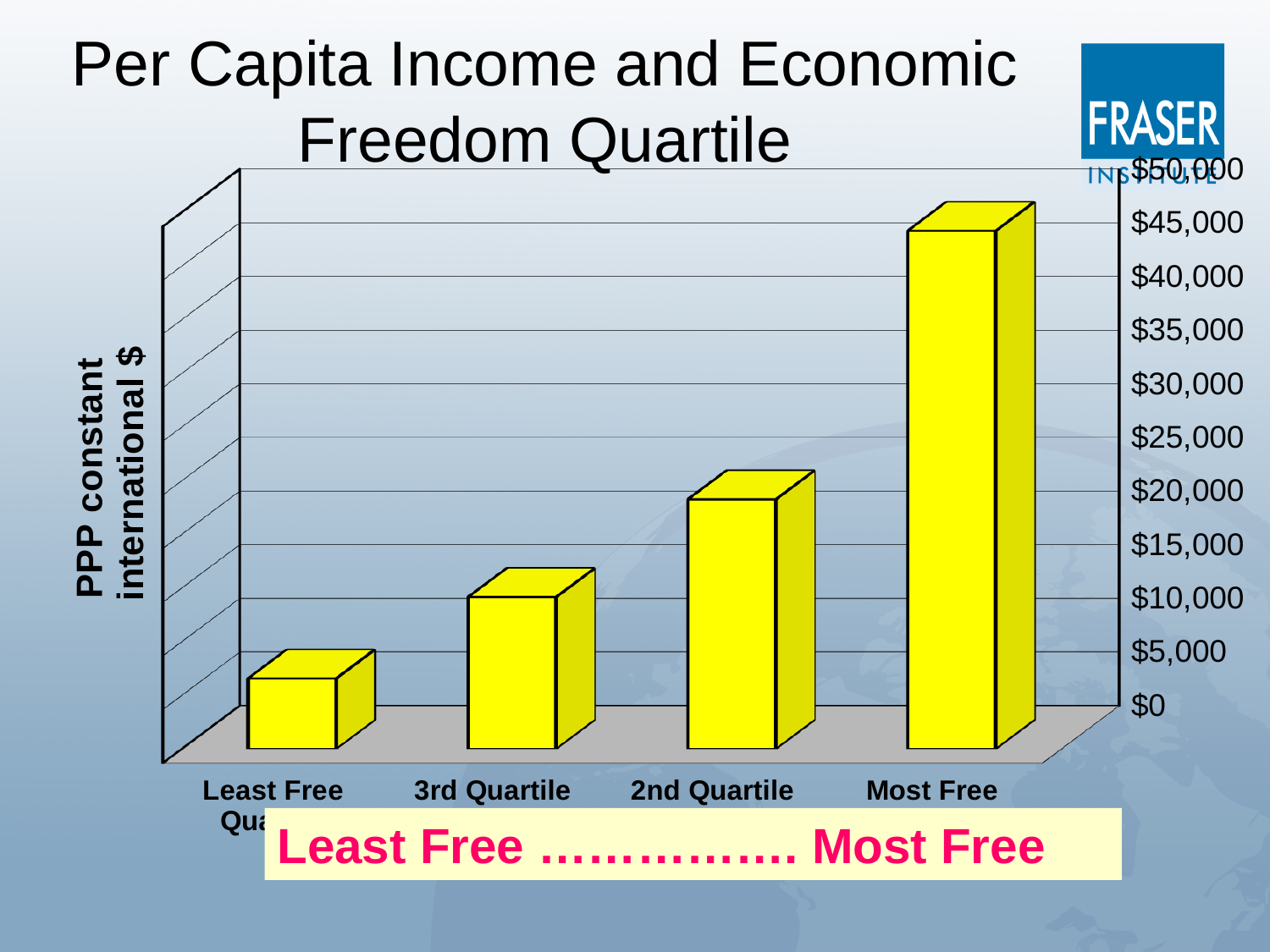
Do the values rise or fall moving from Least Free to Most Free along the x axis? rise Which has a higher per capita income, the 2nd Quartile or the 3rd Quartile? 2nd Quartile What kind of chart is shown on the slide? bar chart Is the value for the 3rd Quartile greater or less than $15,000? less Is the value for the Least Free Quartile greater or less than $10,000? less Is the value for the 2nd Quartile greater or less than $25,000? less How many quartile categories are plotted on the chart? 4 What is the label on the vertical axis of the chart? PPP constant international $ Which category has the lowest per capita income? Least Free Quartile Which category has the highest per capita income? Most Free